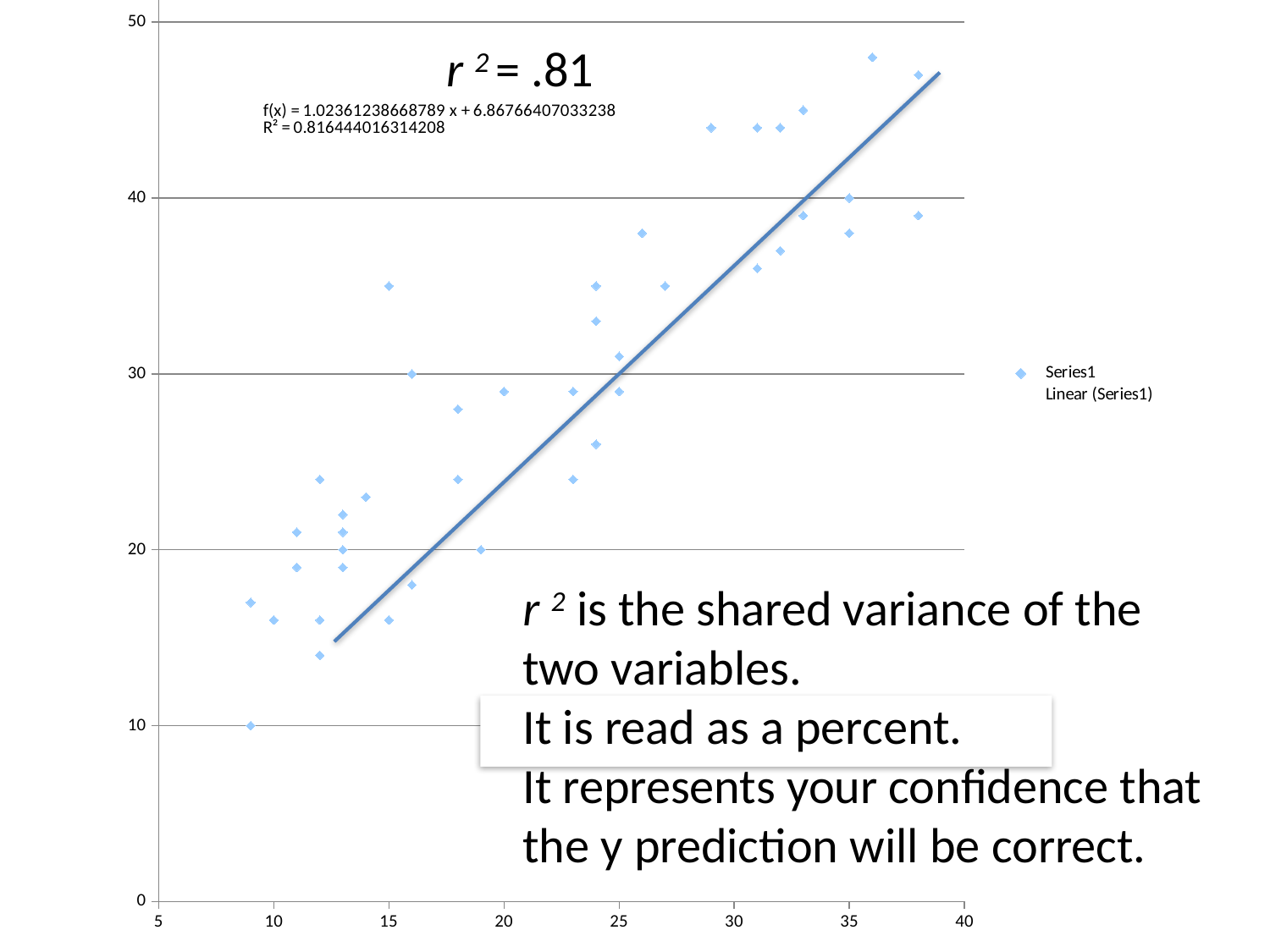
Is the highest plotted point on the chart greater or less than 40? greater What is the highest value labelled on the y axis? 50 Is the lowest plotted point on the chart greater or less than 20? less How many entries does the legend list? 2 What R² value is printed next to the trendline equation? 0.816444016314208 What kind of chart is shown on the slide? scatter chart Is the trendline's value at x = 35 greater or less than 40? greater What r-squared value is shown as the chart's heading? .81 Do the plotted points generally rise or fall as x increases? rise